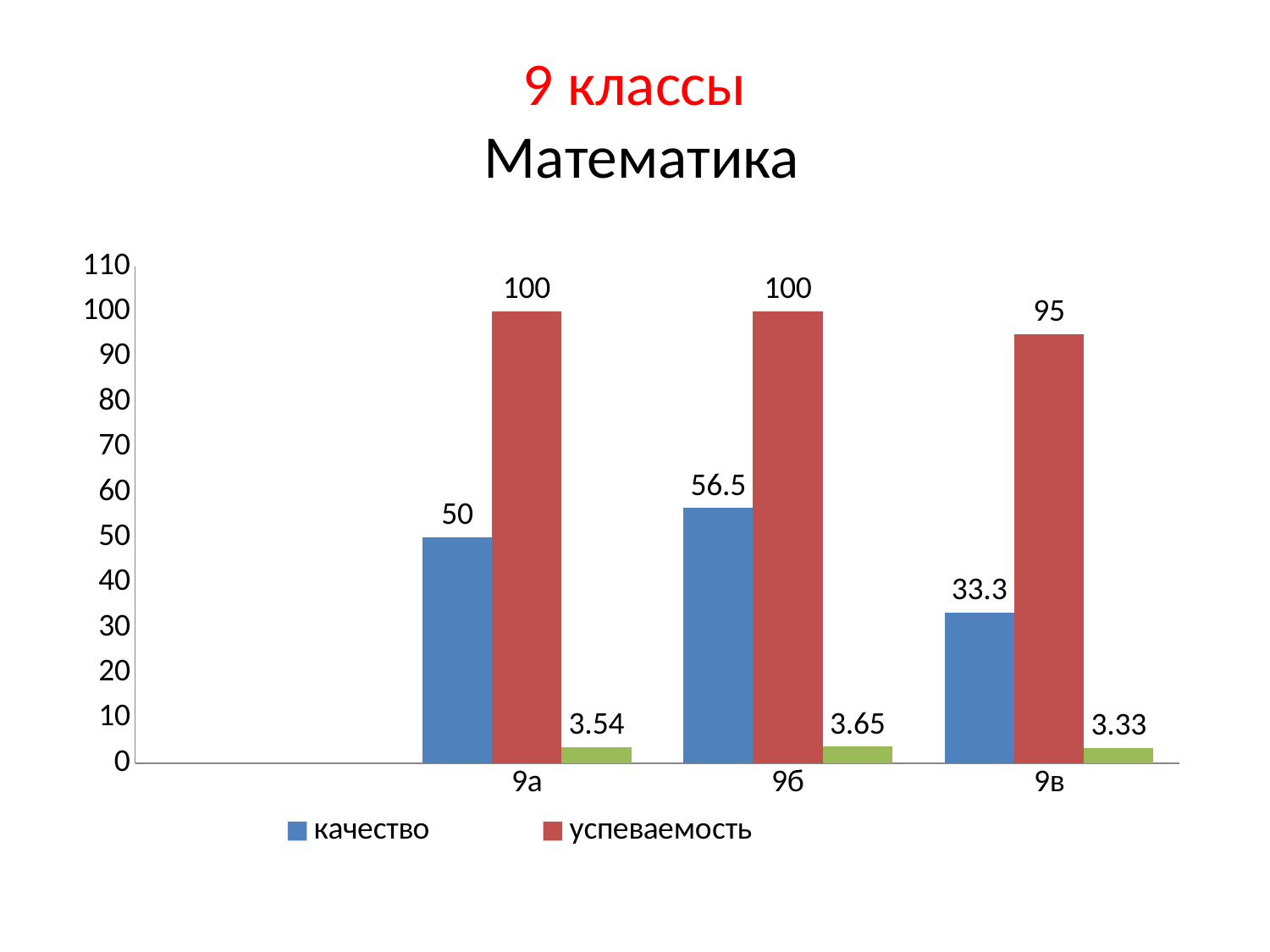
Which is larger, the качество value for 9а or for 9в? 9а Which class has the lowest качество value? 9в What is the difference between the качество values for 9б and 9в? 23.2 Is the качество value for 9в greater or less than 40? less What is the успеваемость value for 9в? 95 How many classes are shown on the x axis? 3 Which class has the highest качество value? 9б How many series does the legend list? 2 What is the качество value for 9а? 50 What is the качество value for 9б? 56.5 What kind of chart is shown on the slide? bar chart What is the difference between the успеваемость values for 9а and 9в? 5